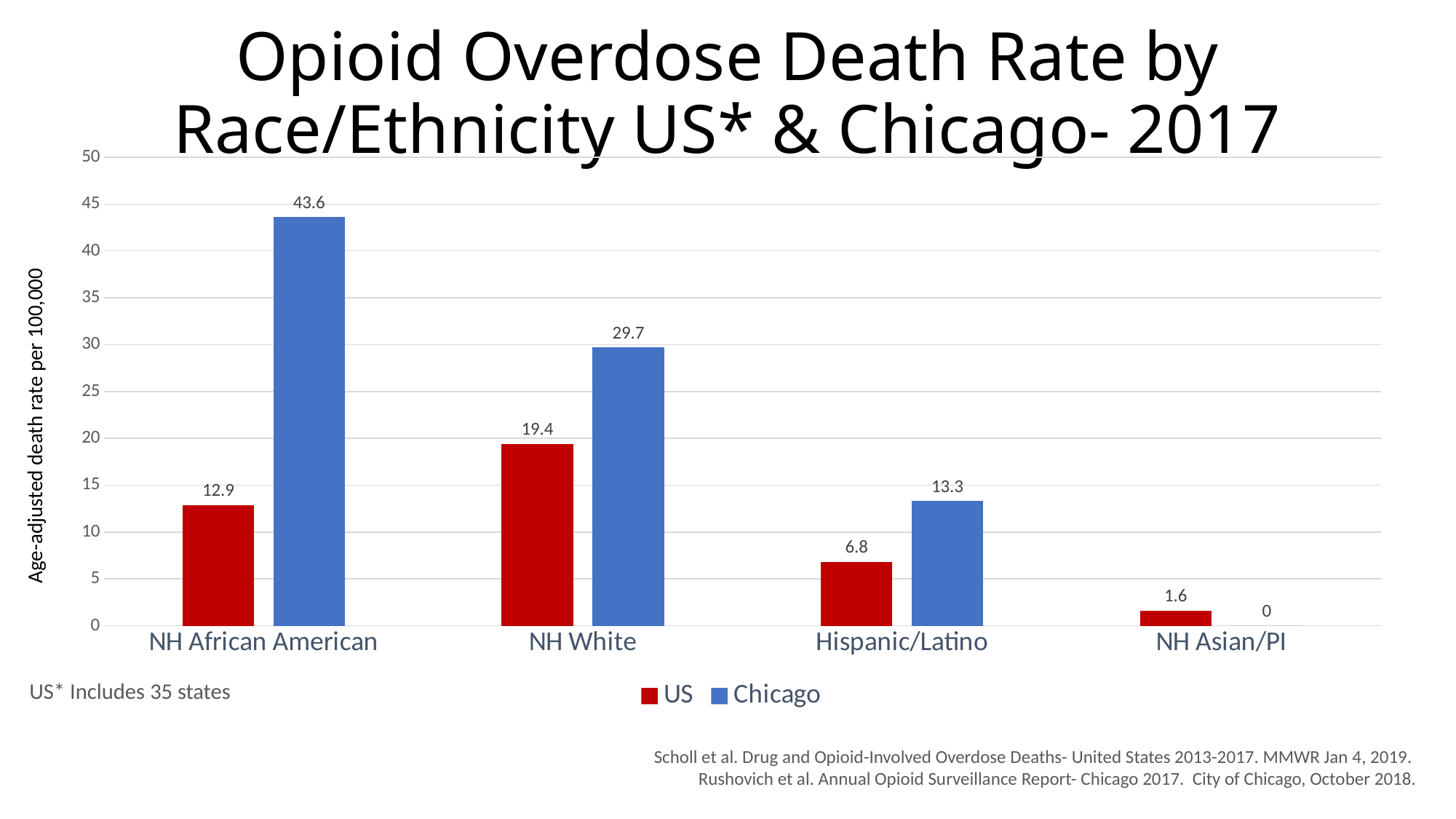
What type of chart is shown on the slide? Bar chart How many race/ethnicity categories are shown on the x axis? 4 What is the US opioid overdose death rate for NH White? 19.4 What is the Chicago value for Hispanic/Latino? 13.3 Which race/ethnicity group has the lowest US death rate? NH Asian/PI Which is larger for Hispanic/Latino, the US rate or the Chicago rate? Chicago Which race/ethnicity group has the highest Chicago death rate? NH African American What is the difference between the Chicago and US death rates for NH White? 10.3 How many series does the legend list? 2 What is the difference between the Chicago and US death rates for NH African American? 30.7 What is the Chicago opioid overdose death rate for NH African American? 43.6 What is the US value for NH Asian/PI? 1.6